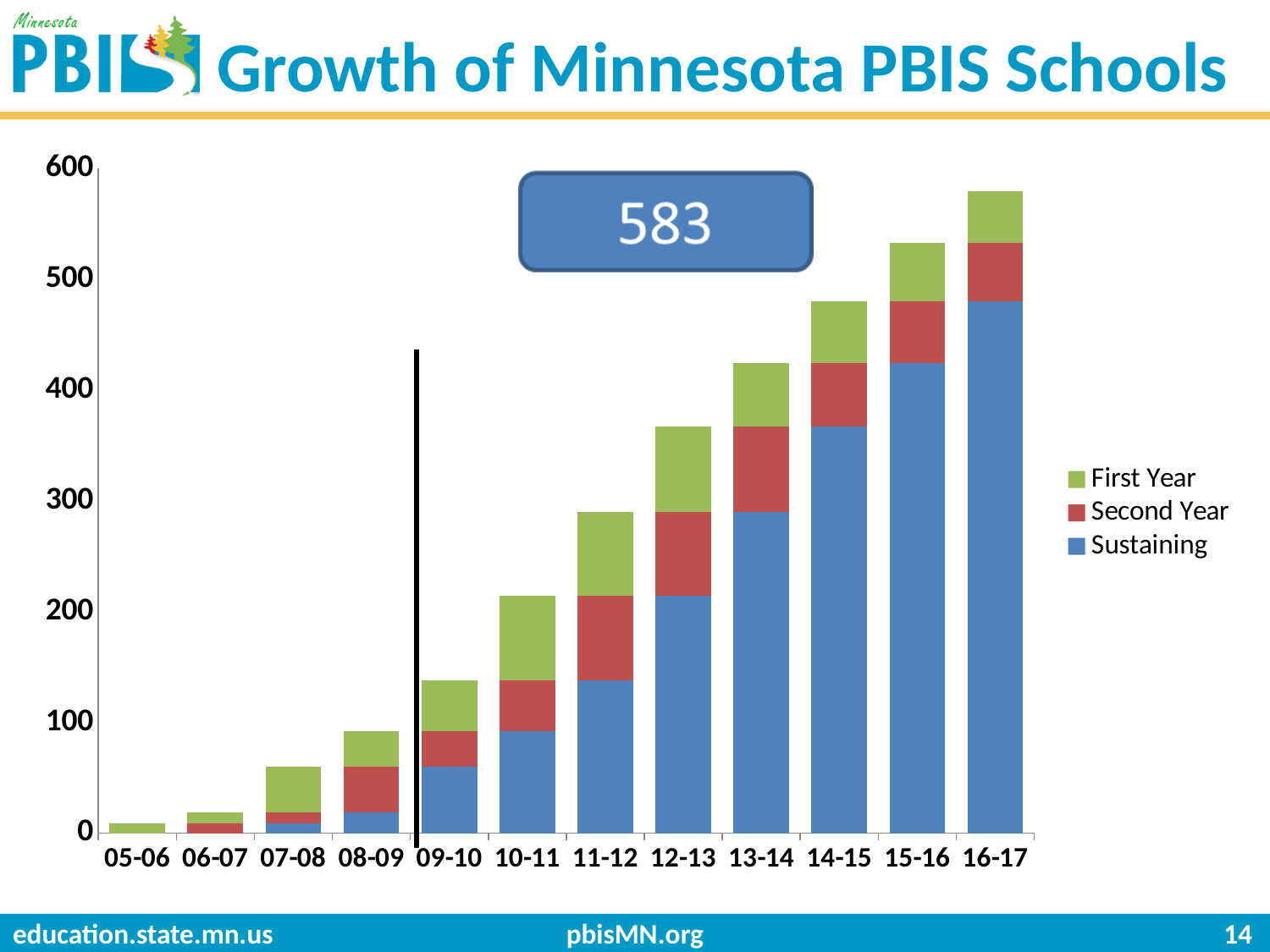
Which has a taller stacked bar, 14-15 or 10-11? 14-15 Is the total bar height for 05-06 greater or less than 100? less Which school year has the shortest stacked bar? 05-06 How many school-year categories are shown on the x axis? 12 Is the total bar height for 12-13 greater or less than 300? greater Is the total bar height for 16-17 greater or less than 500? greater What kind of chart is shown on the slide? Stacked bar chart Do the total bar heights rise or fall from 05-06 to 16-17? rise How many series does the legend list? 3 What number is shown in the callout box above the chart? 583 Which school year has the tallest stacked bar? 16-17